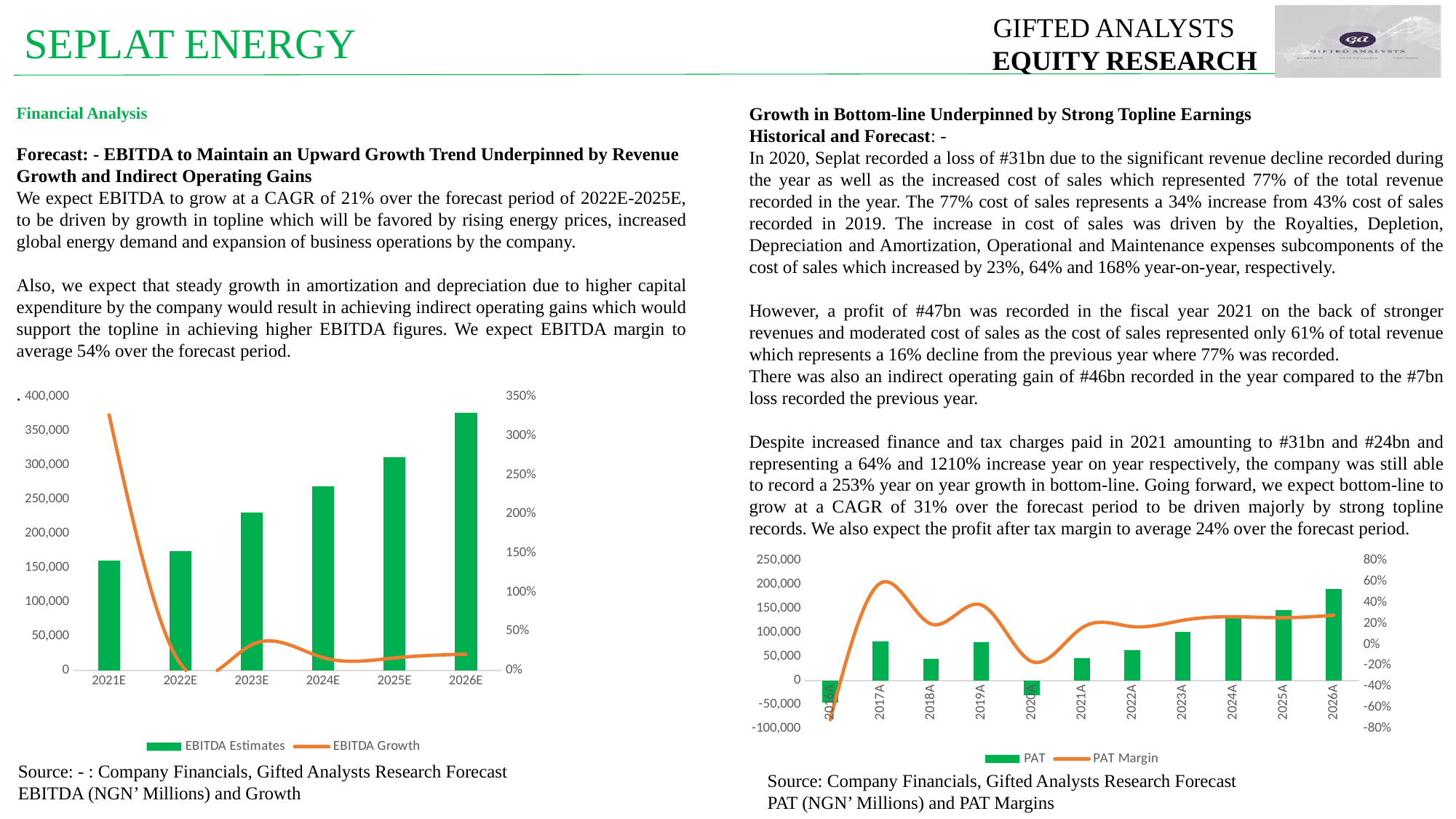
On the PAT (NGN' Millions) and PAT Margins chart, how many years are shown on the x axis? 11 On the PAT (NGN' Millions) and PAT Margins chart, which series is drawn as a line? PAT Margin On the EBITDA (NGN' Millions) and Growth chart, which year has the highest EBITDA Estimates bar? 2026E On the EBITDA (NGN' Millions) and Growth chart, how many series does the legend list? 2 On the EBITDA (NGN' Millions) and Growth chart, do the EBITDA Estimates bars rise or fall from 2021E to 2026E? rise On the EBITDA (NGN' Millions) and Growth chart, is the EBITDA Estimates value for 2026E greater or less than 350,000? greater On the PAT (NGN' Millions) and PAT Margins chart, which year has the highest PAT bar? 2026A On the EBITDA (NGN' Millions) and Growth chart, which year has the lowest EBITDA Estimates bar? 2021E On the PAT (NGN' Millions) and PAT Margins chart, which year has the lowest PAT bar? 2016A On the PAT (NGN' Millions) and PAT Margins chart, is the PAT value for 2020A greater or less than 0? less On the EBITDA (NGN' Millions) and Growth chart, is the EBITDA Estimates value for 2024E greater or less than 250,000? greater On the EBITDA (NGN' Millions) and Growth chart, how many years are shown on the x axis? 6